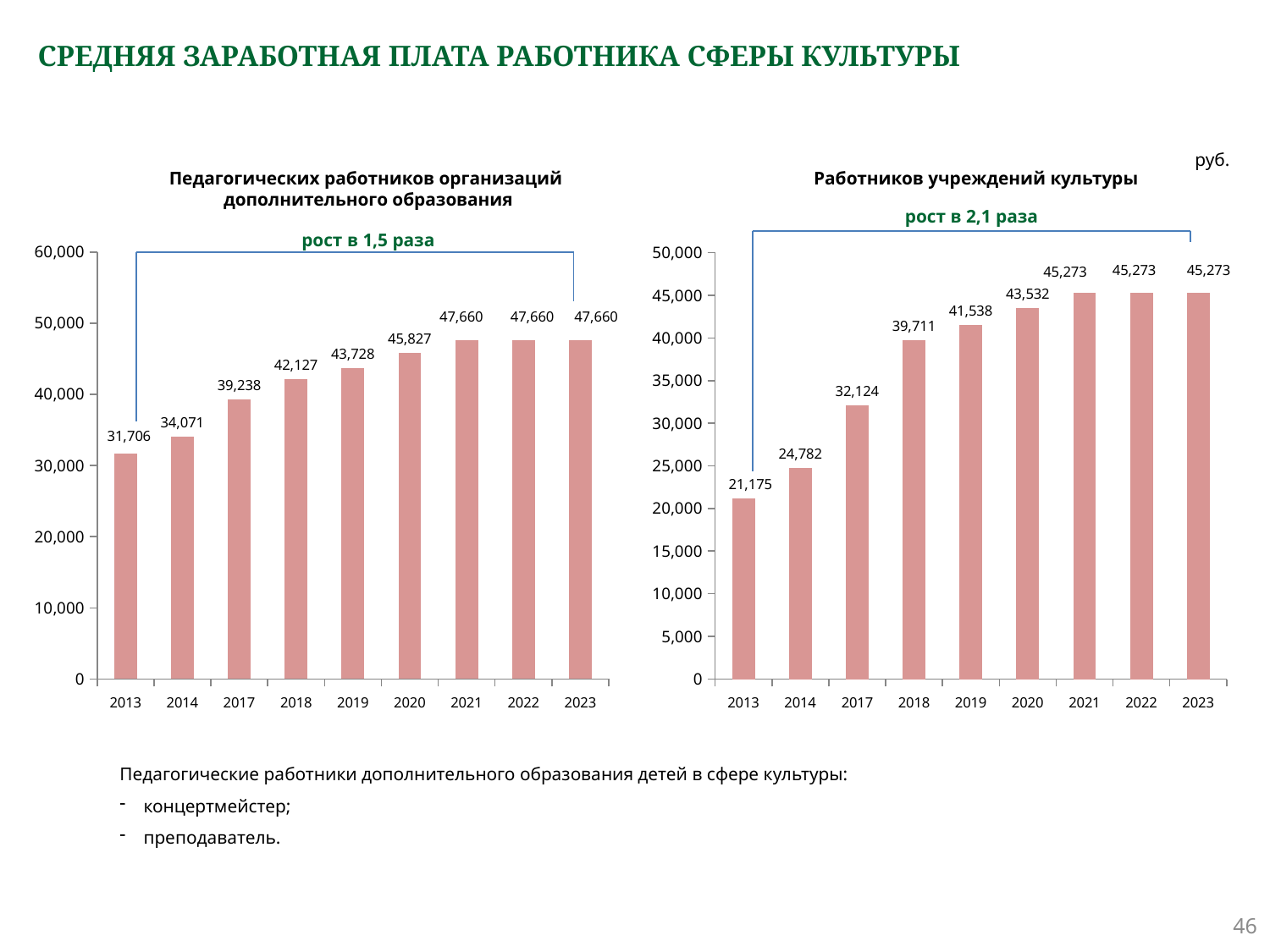
In the right chart (Работников учреждений культуры), do the values rise or fall from 2013 to 2023? rise In the right chart (Работников учреждений культуры), what is the value for 2019? 41,538 How many years are shown on the x axis of the right chart (Работников учреждений культуры)? 9 What growth factor is annotated above the right chart (Работников учреждений культуры)? рост в 2,1 раза What kind of chart is the left chart (Педагогических работников организаций дополнительного образования)? bar chart In the left chart (Педагогических работников организаций дополнительного образования), what is the difference between the values for 2023 and 2013? 15,954 In the left chart (Педагогических работников организаций дополнительного образования), is the value for 2020 greater or less than 40,000? greater In the left chart (Педагогических работников организаций дополнительного образования), what is the value for 2013? 31,706 In the right chart (Работников учреждений культуры), which year has the lowest value? 2013 In the left chart (Педагогических работников организаций дополнительного образования), what is the value for 2018? 42,127 In the right chart (Работников учреждений культуры), which is larger: the value for 2017 or the value for 2018? 2018 In the right chart (Работников учреждений культуры), what is the difference between the values for 2014 and 2013? 3,607